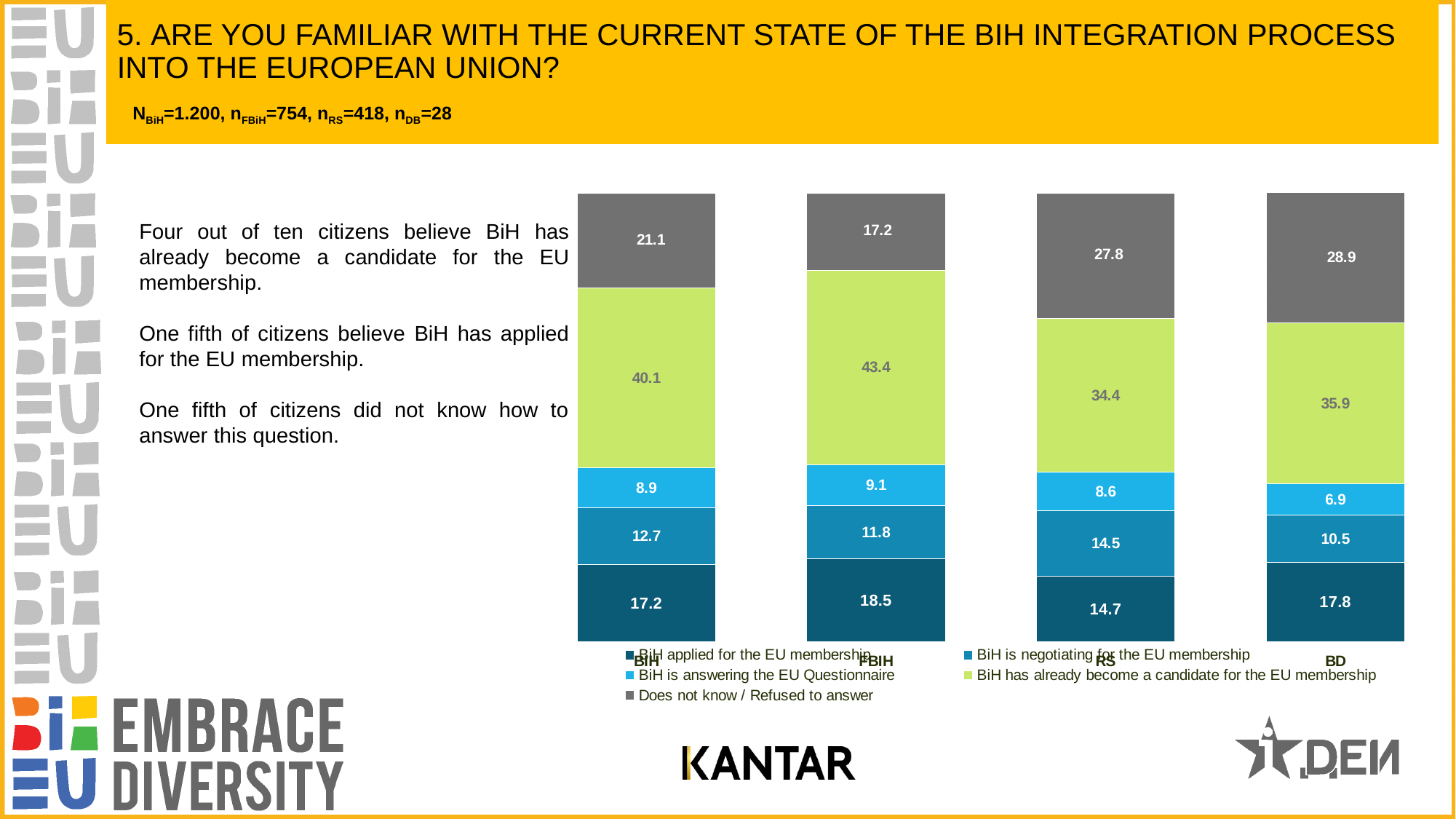
What is the value for 'Does not know / Refused to answer' in the RS bar? 27.8 What kind of chart is shown on the slide? Stacked bar chart How many categories (entities) are shown along the x axis of the chart? 4 What is the total of the stacked bar for BiH? 100.0 Which is larger: the 'BiH is negotiating for the EU membership' value for RS or for BD? RS Which colour represents 'Does not know / Refused to answer' in the chart? Grey What is the value for 'BiH has already become a candidate for the EU membership' in the FBiH bar? 43.4 What is the difference between the 'Does not know / Refused to answer' values for BD and FBiH? 11.7 How many series does the chart legend list? 5 Which entity has the highest value for 'BiH has already become a candidate for the EU membership'? FBiH Which entity has the lowest value for 'BiH is answering the EU Questionnaire'? BD What is the value for 'BiH applied for the EU membership' in the BD bar? 17.8